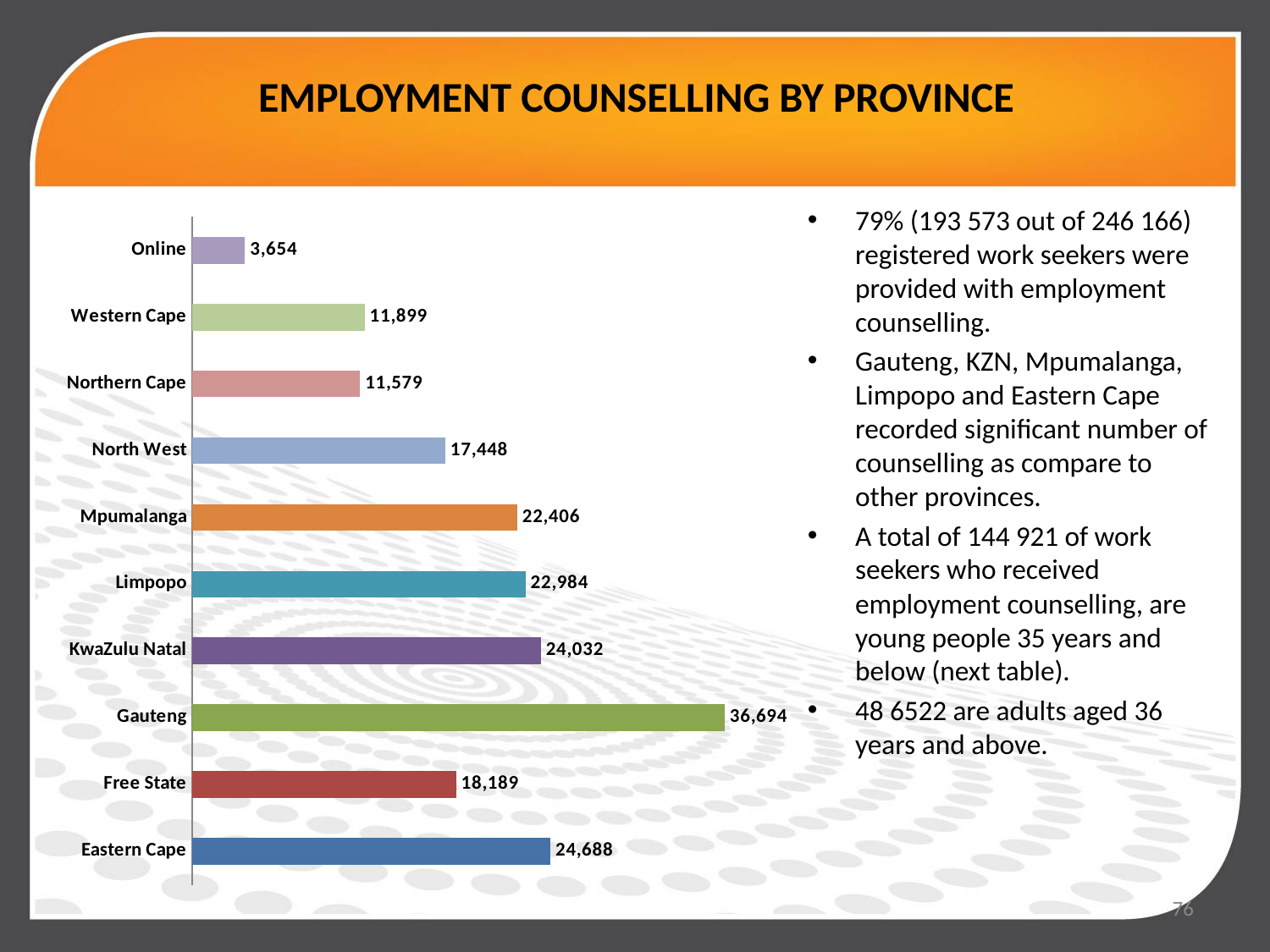
Which is larger, the value for KwaZulu Natal or the value for Eastern Cape? Eastern Cape How many categories are shown in the chart? 10 What is the difference between the values for Gauteng and Eastern Cape? 12,006 What is the value for Northern Cape? 11,579 Which is larger, the value for Limpopo or the value for Mpumalanga? Limpopo What kind of chart is shown on the slide? Bar chart What is the title of the slide containing the chart? EMPLOYMENT COUNSELLING BY PROVINCE What is the difference between the values for Western Cape and Northern Cape? 320 What is the value for Free State? 18,189 What is the value for Gauteng? 36,694 Which category has the highest value? Gauteng Which category has the lowest value? Online